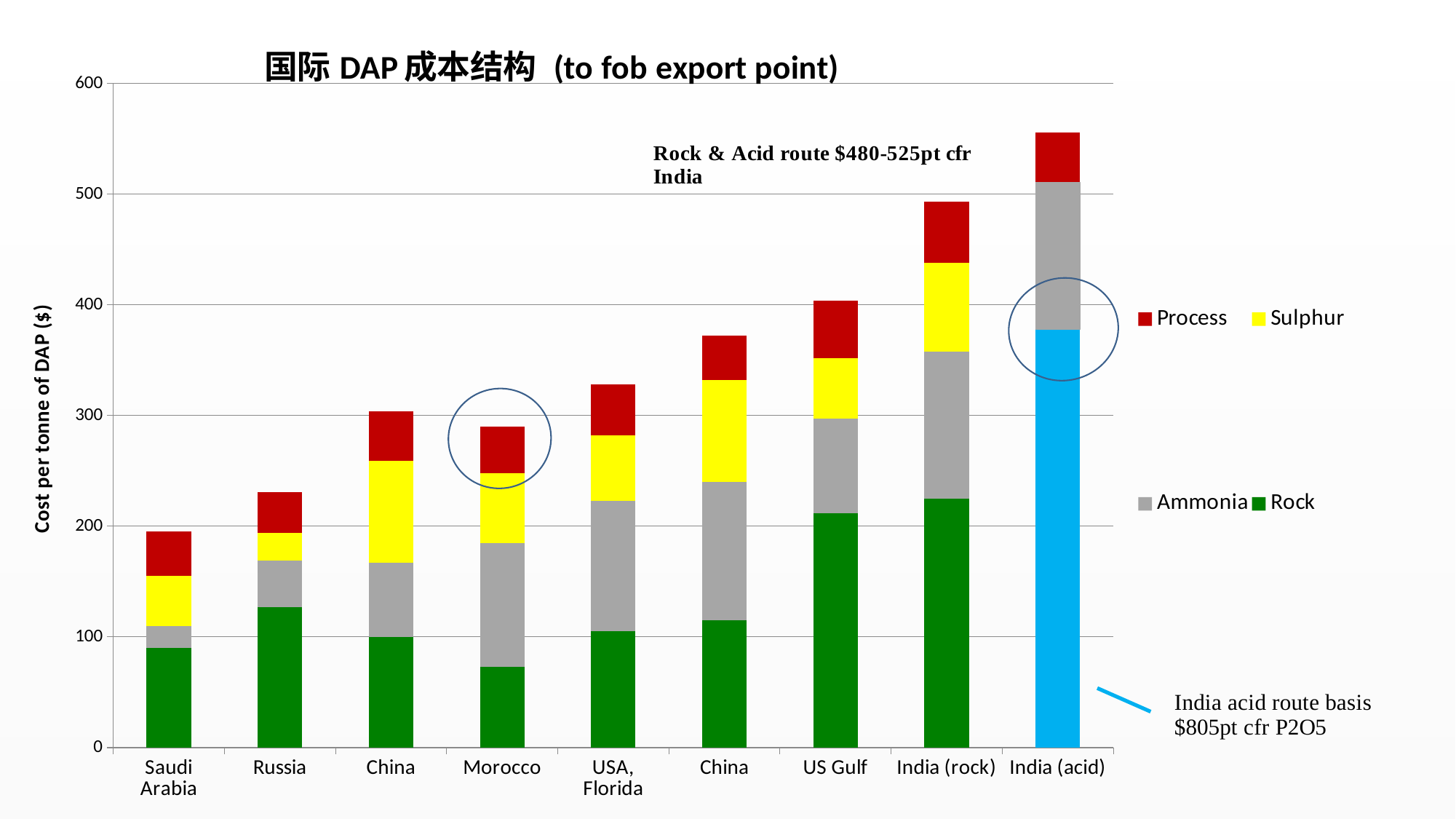
Is the total cost for India (acid) greater or less than 500? greater Is the total cost for Saudi Arabia greater or less than 200? less Which has a larger total cost, Russia or Morocco? Morocco Which category has the highest total cost per tonne of DAP? India (acid) What is the label of the y axis? Cost per tonne of DAP ($) Do the total bar heights rise or fall moving from left to right along the x axis? Rise How many categories are shown along the x axis? 9 Is the Rock segment for US Gulf greater or less than 200? greater What kind of chart is shown on the slide? Stacked bar chart How many series does the legend list? 4 Which category has the lowest total cost per tonne of DAP? Saudi Arabia